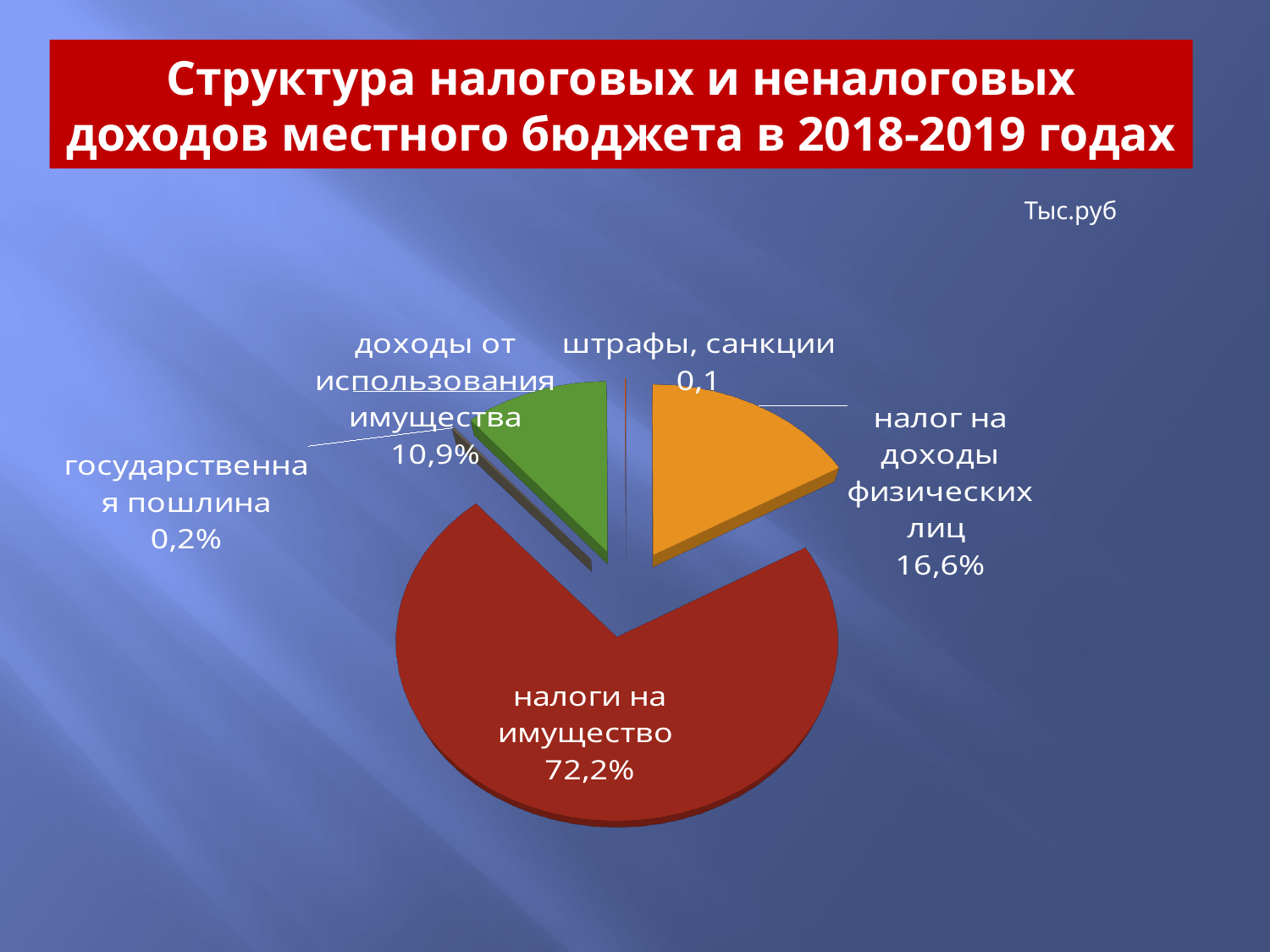
What share of the pie does "налоги на имущество" have? 72,2% What is the value shown for "государственная пошлина"? 0,2% What is the title of the slide containing the chart? Структура налоговых и неналоговых доходов местного бюджета в 2018-2019 годах What value is printed for "штрафы, санкции"? 0,1 Which is larger: "налог на доходы физических лиц" or "доходы от использования имущества"? налог на доходы физических лиц What is the value shown for "налог на доходы физических лиц"? 16,6% Which category has the smallest slice of the pie? штрафы, санкции How many slices does the pie chart have? 5 Which category has the largest slice of the pie? налоги на имущество What is the value shown for "доходы от использования имущества"? 10,9% What kind of chart is shown on the slide? pie chart What is the difference in percentage points between "налоги на имущество" and "налог на доходы физических лиц"? 55,6